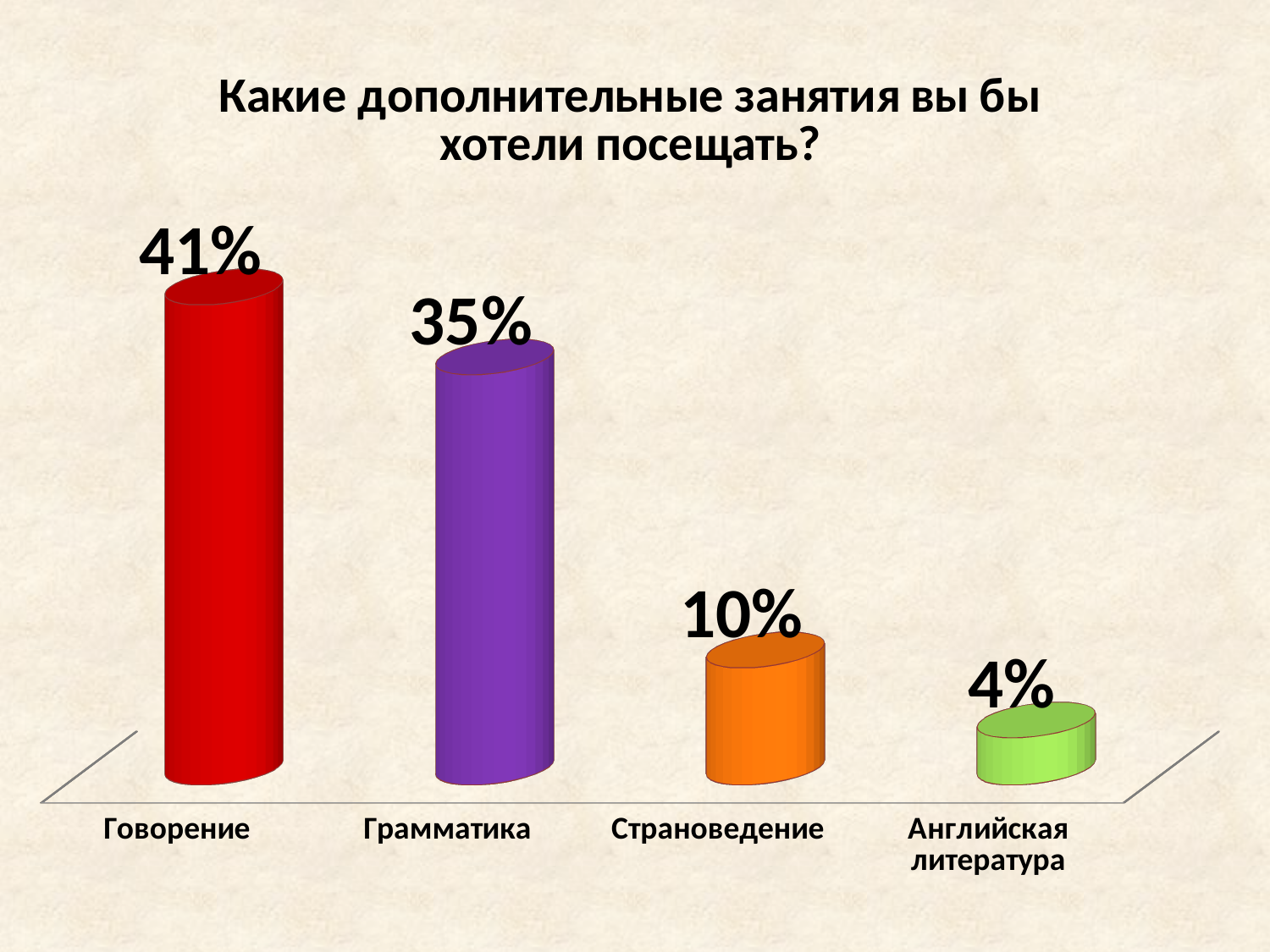
What is the value for Говорение? 41% What is the value for Грамматика? 35% Which category has the lowest value? Английская литература Which category has the highest value? Говорение What is the difference between the values for Страноведение and Английская литература? 6% What is the value for Страноведение? 10% Which is larger, the value for Грамматика or the value for Страноведение? Грамматика What kind of chart is shown on the slide? Bar chart What is the title of the chart? Какие дополнительные занятия вы бы хотели посещать? What is the value for Английская литература? 4% What is the difference between the values for Говорение and Грамматика? 6% How many categories are shown in the chart? 4